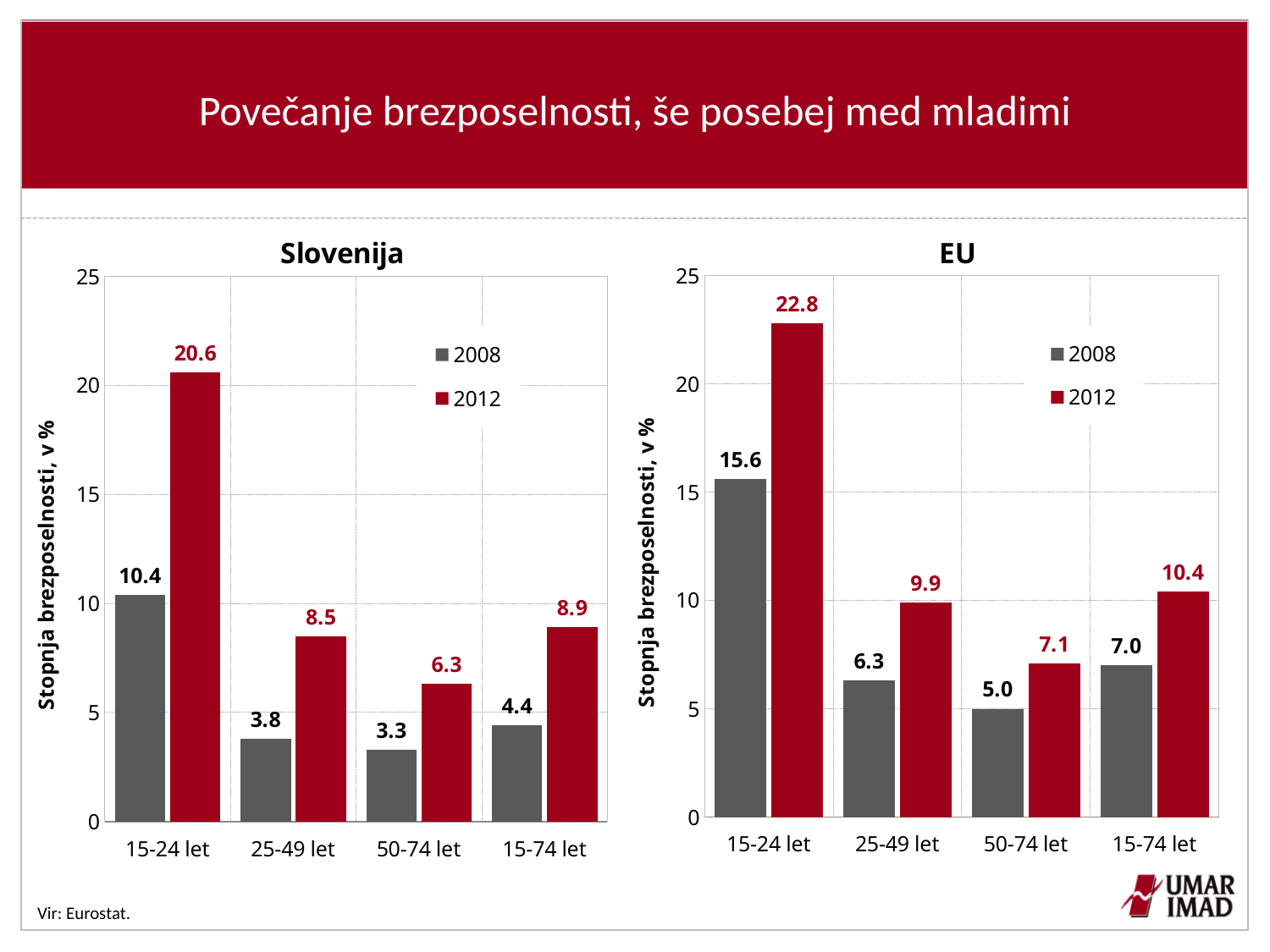
In the Slovenija chart, what is the difference between the 2012 and 2008 values for 15-24 let? 10.2 How many series does the legend of the Slovenija chart list? 2 In the EU chart, what is the difference between the 2012 and 2008 values for 15-74 let? 3.4 In the EU chart, which is larger: the 2012 value for 25-49 let or the 2012 value for 50-74 let? 25-49 let What is the y-axis label of the Slovenija chart? Stopnja brezposelnosti, v % What kind of chart is the EU chart? bar chart In the Slovenija chart, which age group has the highest 2012 value? 15-24 let In the EU chart, which age group has the lowest 2008 value? 50-74 let In the EU chart, what is the 2008 value for 25-49 let? 6.3 In the Slovenija chart, is the 2012 value for 15-24 let greater or less than 20? greater In the Slovenija chart, what is the 2012 value for 15-24 let? 20.6 How many age groups are shown on the x axis of the EU chart? 4